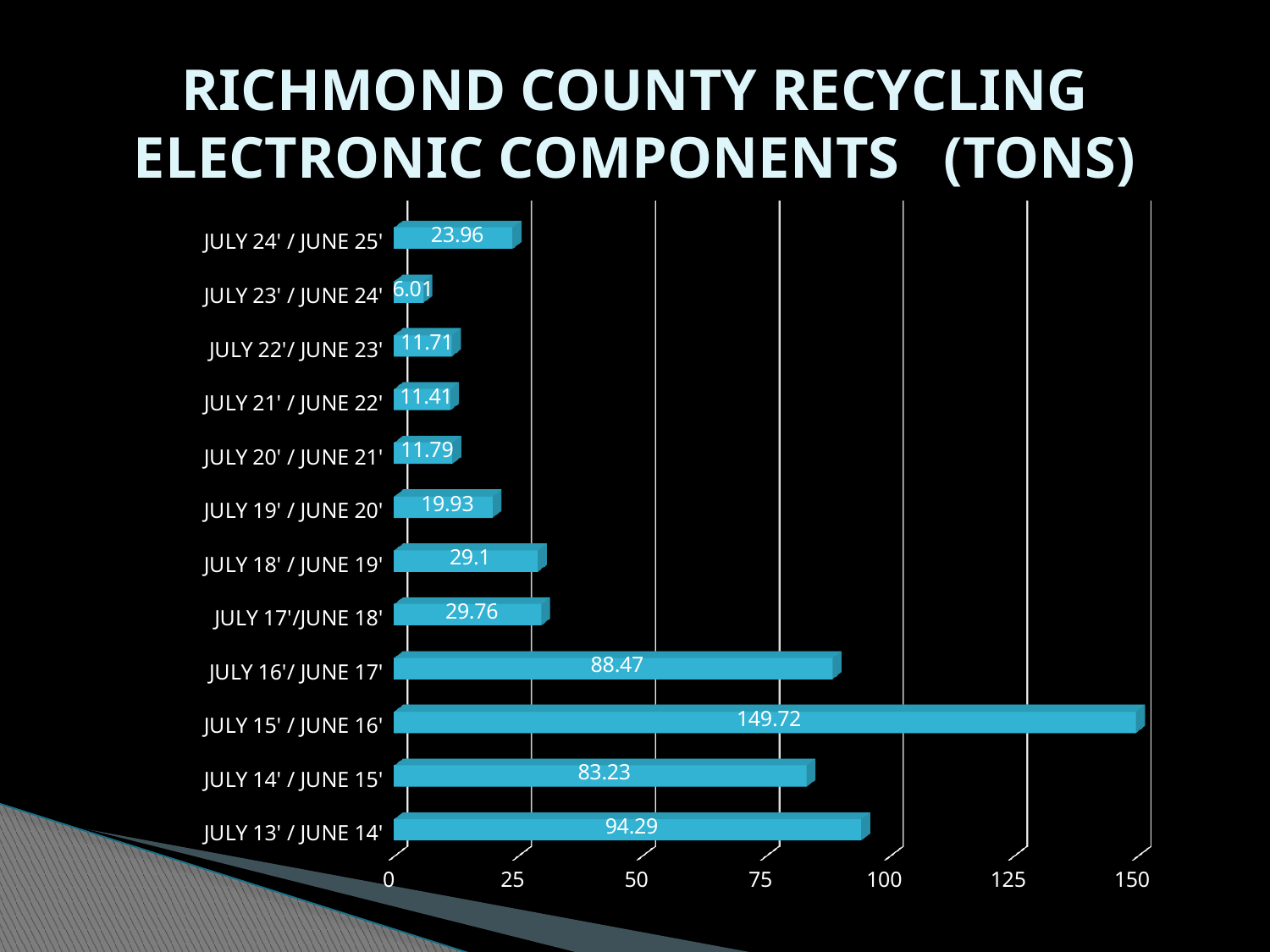
Which period has the highest value? JULY 15' / JUNE 16' Which is larger, the value for JULY 13' / JUNE 14' or the value for JULY 14' / JUNE 15'? JULY 13' / JUNE 14' What is the difference between the values for JULY 15' / JUNE 16' and JULY 16' / JUNE 17'? 61.25 How many periods are shown on the chart? 12 Which period has the lowest value? JULY 23' / JUNE 24' What kind of chart is shown on the slide? bar chart What is the value for JULY 23' / JUNE 24'? 6.01 What is the value for JULY 13' / JUNE 14'? 94.29 What is the difference between the values for JULY 24' / JUNE 25' and JULY 23' / JUNE 24'? 17.95 Is the value for JULY 16' / JUNE 17' greater or less than 75? greater What is the value for JULY 19' / JUNE 20'? 19.93 What is the value for JULY 15' / JUNE 16'? 149.72